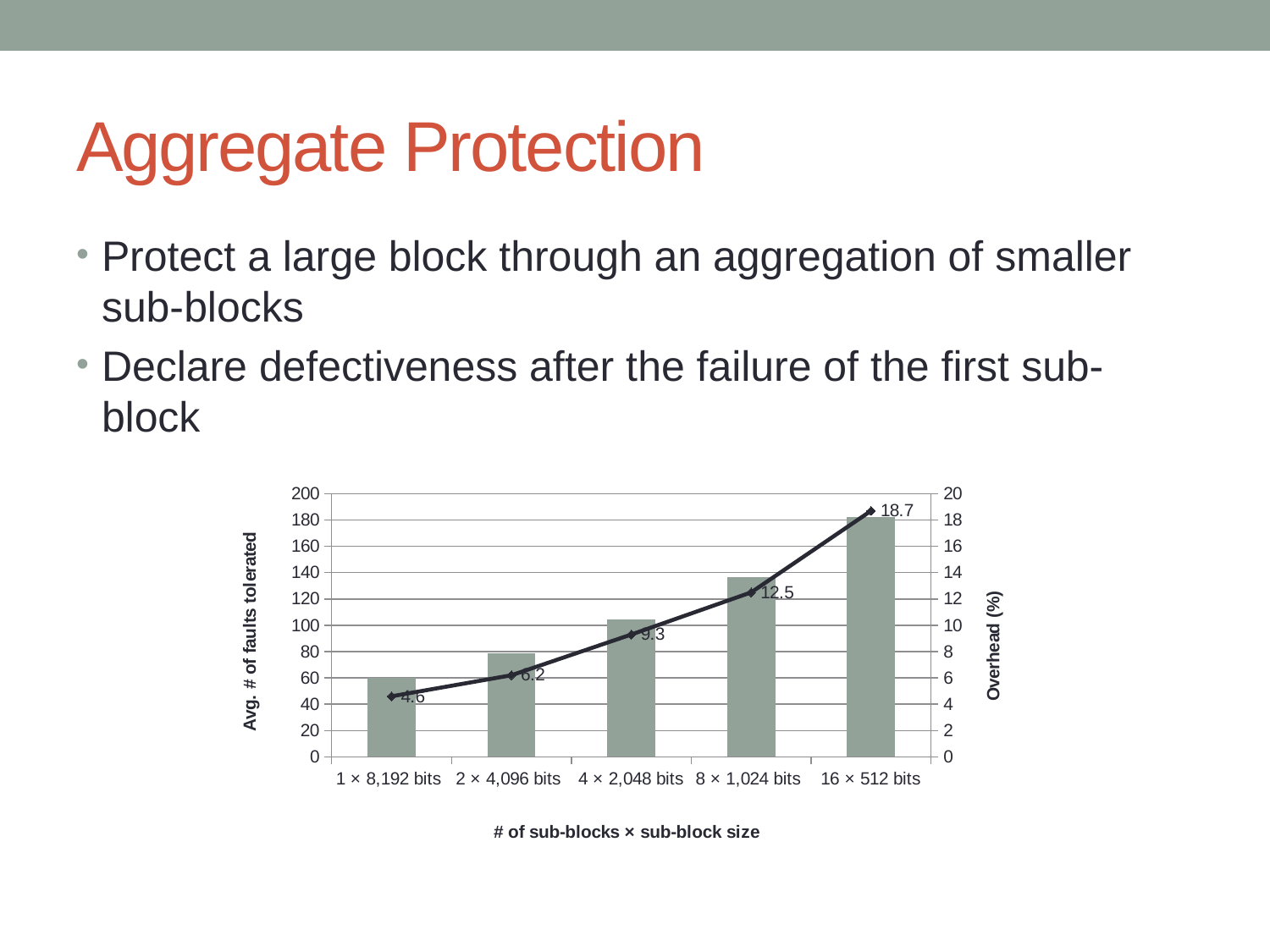
Which has a higher average number of faults tolerated, 2 × 4,096 bits or 8 × 1,024 bits? 8 × 1,024 bits Does the overhead (%) rise or fall as the number of sub-blocks increases along the x axis? rise Which configuration has the lowest overhead (%)? 1 × 8,192 bits Is the average number of faults tolerated for 8 × 1,024 bits greater or less than 120? greater How many sub-block configurations are shown on the x axis? 5 What is the overhead (%) for 1 × 8,192 bits? 4.6 What is the overhead (%) for 4 × 2,048 bits? 9.3 What is the label of the right-hand vertical axis? Overhead (%) Which configuration has the highest overhead (%)? 16 × 512 bits What is the difference in overhead (%) between 16 × 512 bits and 8 × 1,024 bits? 6.2 What is the overhead (%) for 16 × 512 bits? 18.7 Is the average number of faults tolerated for 16 × 512 bits greater or less than 160? greater